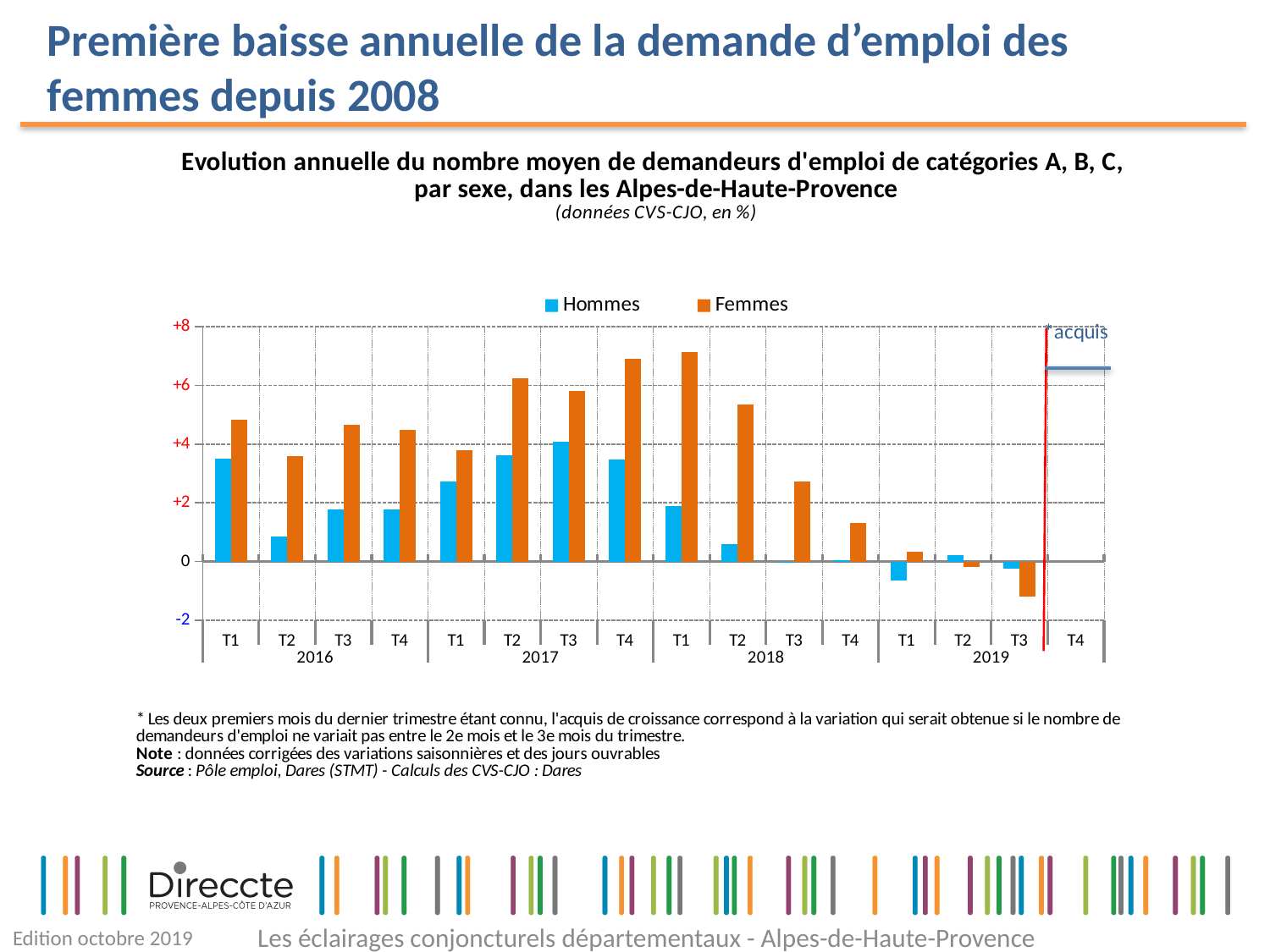
Which two series are shown in the legend? Hommes and Femmes What kind of chart is shown on the slide? bar chart In which quarter is the Hommes value highest? T3 2017 How many series does the legend list? 2 Is the value for Femmes in T3 2019 greater or less than 0? less Is the value for Femmes in T1 2016 greater or less than +4? greater Is the value for Hommes in T2 2016 greater or less than +2? less In which quarter is the Femmes value lowest? T3 2019 In T2 2017, which series has the larger value, Hommes or Femmes? Femmes How many years are labelled along the x axis? 4 Do the Femmes values rise or fall from T1 2018 to T3 2019? fall